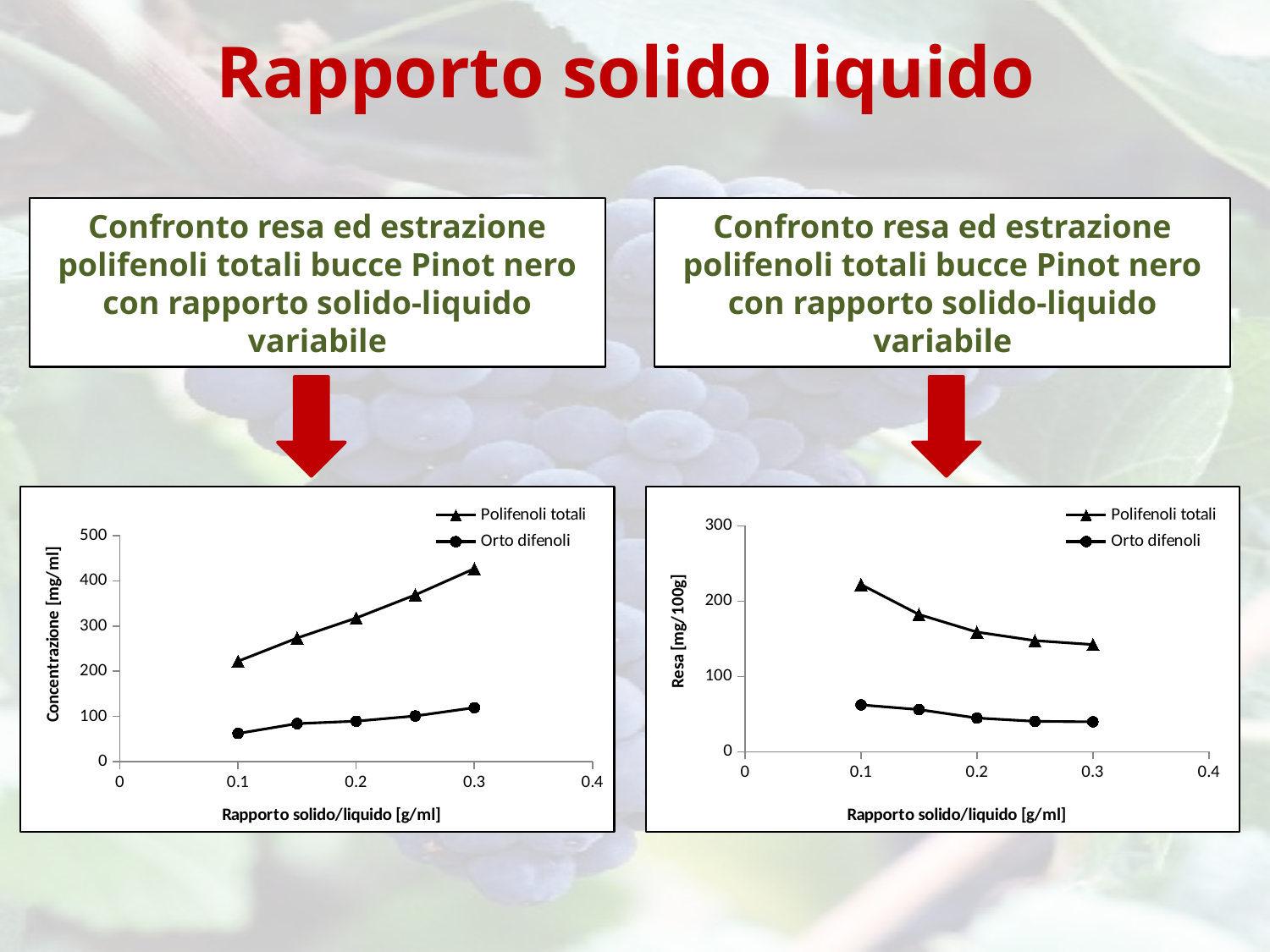
How many series does the legend of the right chart list? 2 In the left chart, is the Polifenoli totali value at a ratio of 0.3 greater or less than 400? greater In the left chart, do the Polifenoli totali values rise or fall as the solid/liquid ratio increases? rise What kind of chart is the left chart on the slide? line chart What is the y-axis title of the right chart? Resa [mg/100g] How many data points does the Polifenoli totali series have in the left chart? 5 In the right chart, is the Polifenoli totali value at a ratio of 0.3 greater or less than 200? less What is the x-axis title of the left chart? Rapporto solido/liquido [g/ml] In the right chart, do the Polifenoli totali values rise or fall as the solid/liquid ratio increases? fall In the right chart, is the Polifenoli totali value at a ratio of 0.1 greater or less than 200? greater In the right chart, which series has the higher value at a ratio of 0.2, Polifenoli totali or Orto difenoli? Polifenoli totali